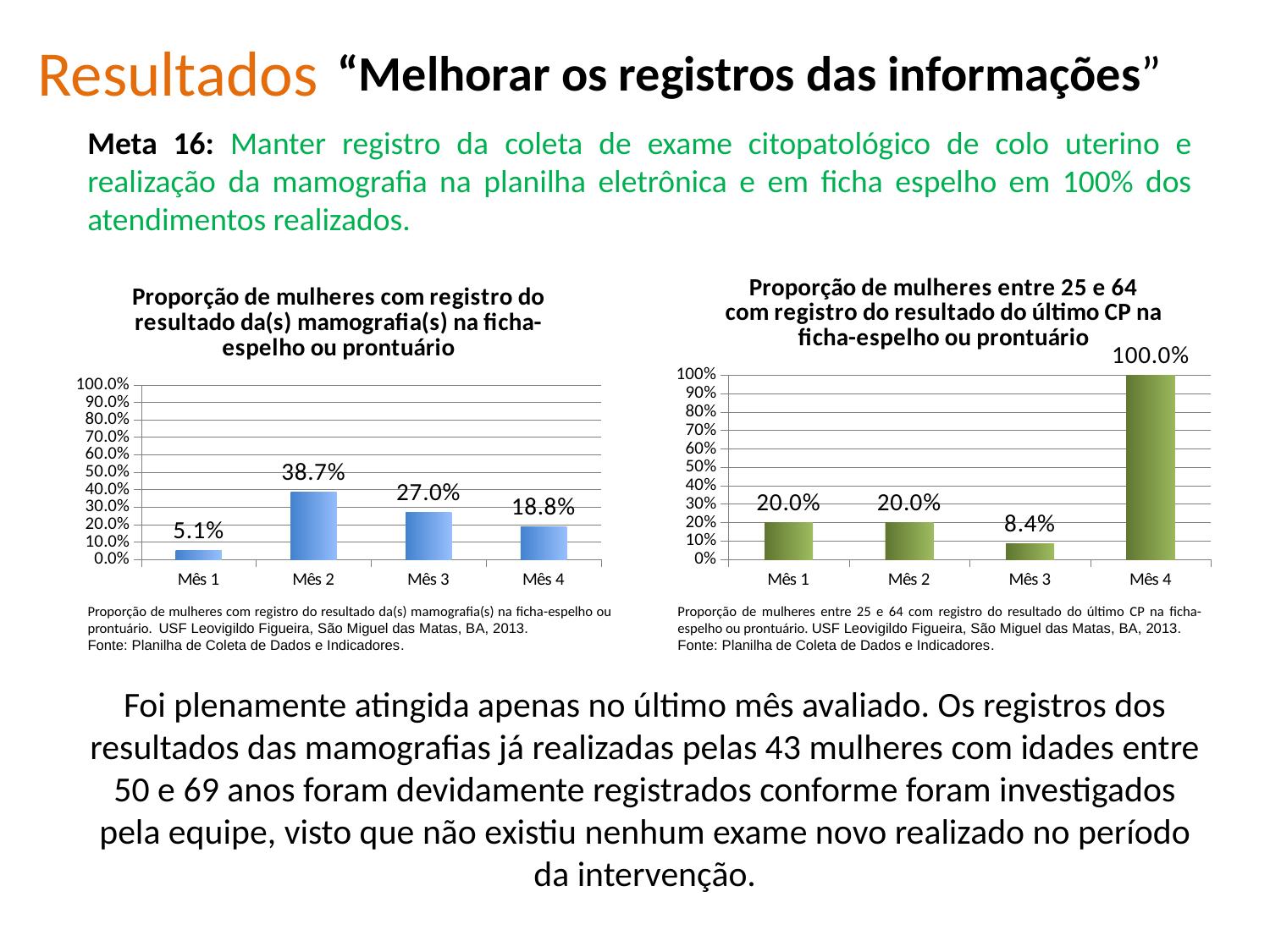
In the left chart (mammography records), how many months are plotted? 4 In the right chart (CP records, women 25 to 64), what is the difference between Mês 4 and Mês 1? 80.0% In the left chart (mammography records), what is the difference between Mês 3 and Mês 4? 8.2% In the left chart (mammography records), what is the value for Mês 1? 5.1% In the right chart (CP records, women 25 to 64), what is the value for Mês 3? 8.4% In the left chart (mammography records), what is the value for Mês 2? 38.7% What type of chart is the right chart (CP records, women 25 to 64)? Bar chart In the left chart (mammography records), which month has the lowest value? Mês 1 In the left chart (mammography records), which month has the highest value? Mês 2 In the right chart (CP records, women 25 to 64), what is the value for Mês 4? 100.0% Which is larger: Mês 3 in the left chart or Mês 3 in the right chart? Mês 3 in the left chart In the right chart (CP records, women 25 to 64), which month has the lowest value? Mês 3